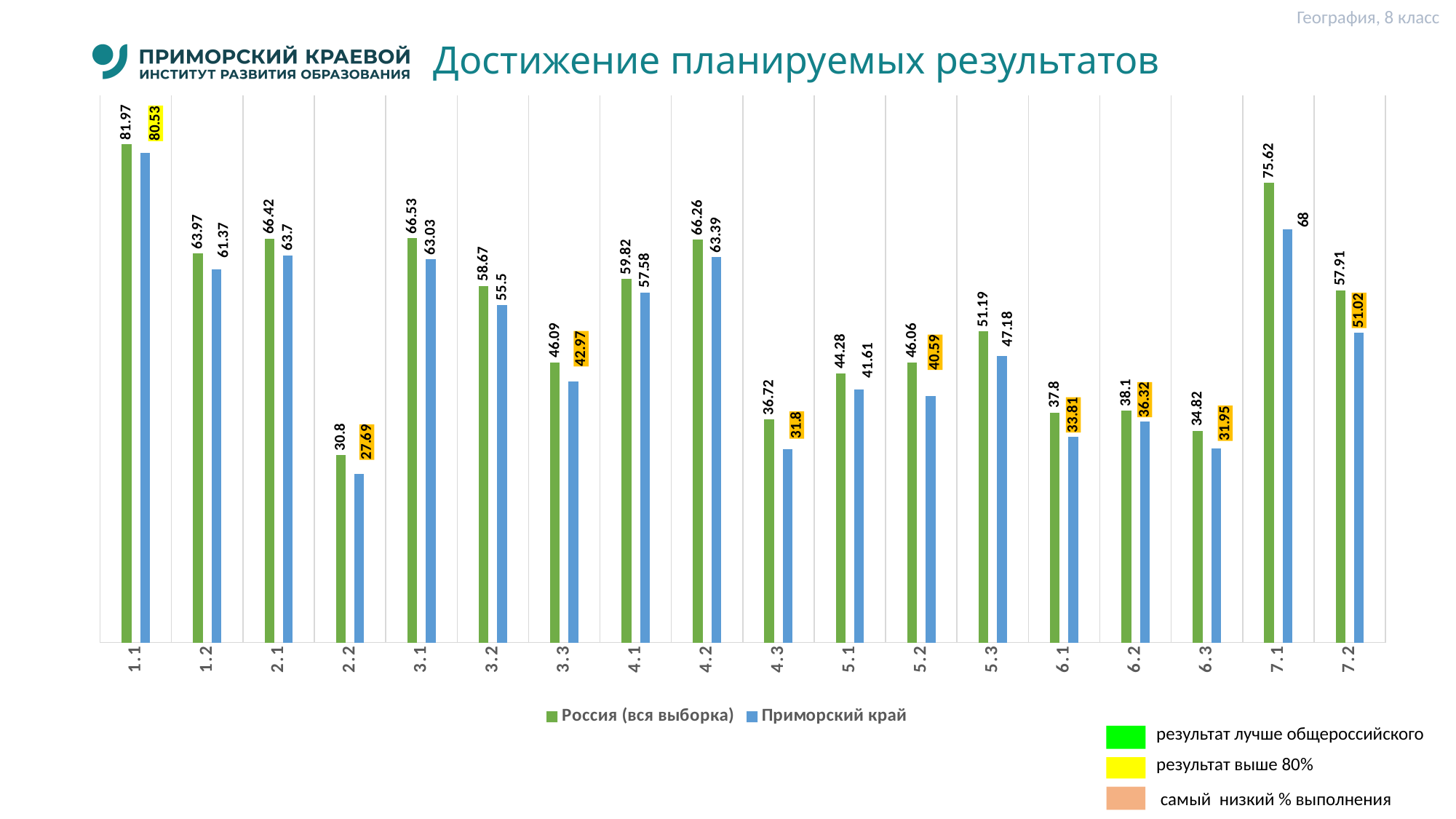
Which category has the highest value for Россия (вся выборка)? 1.1 How many categories are shown on the x axis? 18 Which category has the lowest value for Приморский край? 2.2 What is the title of the chart on the slide? Достижение планируемых результатов What kind of chart is shown on the slide? bar chart What is the value for Приморский край at category 1.1? 80.53 What is the difference between Россия (вся выборка) and Приморский край at category 4.3? 4.92 What is the value for Приморский край at category 2.2? 27.69 What is the difference between Россия (вся выборка) and Приморский край at category 7.1? 7.62 How many series does the chart legend list? 2 Which is larger at category 5.3: Россия (вся выборка) or Приморский край? Россия (вся выборка) What is the value for Россия (вся выборка) at category 7.1? 75.62